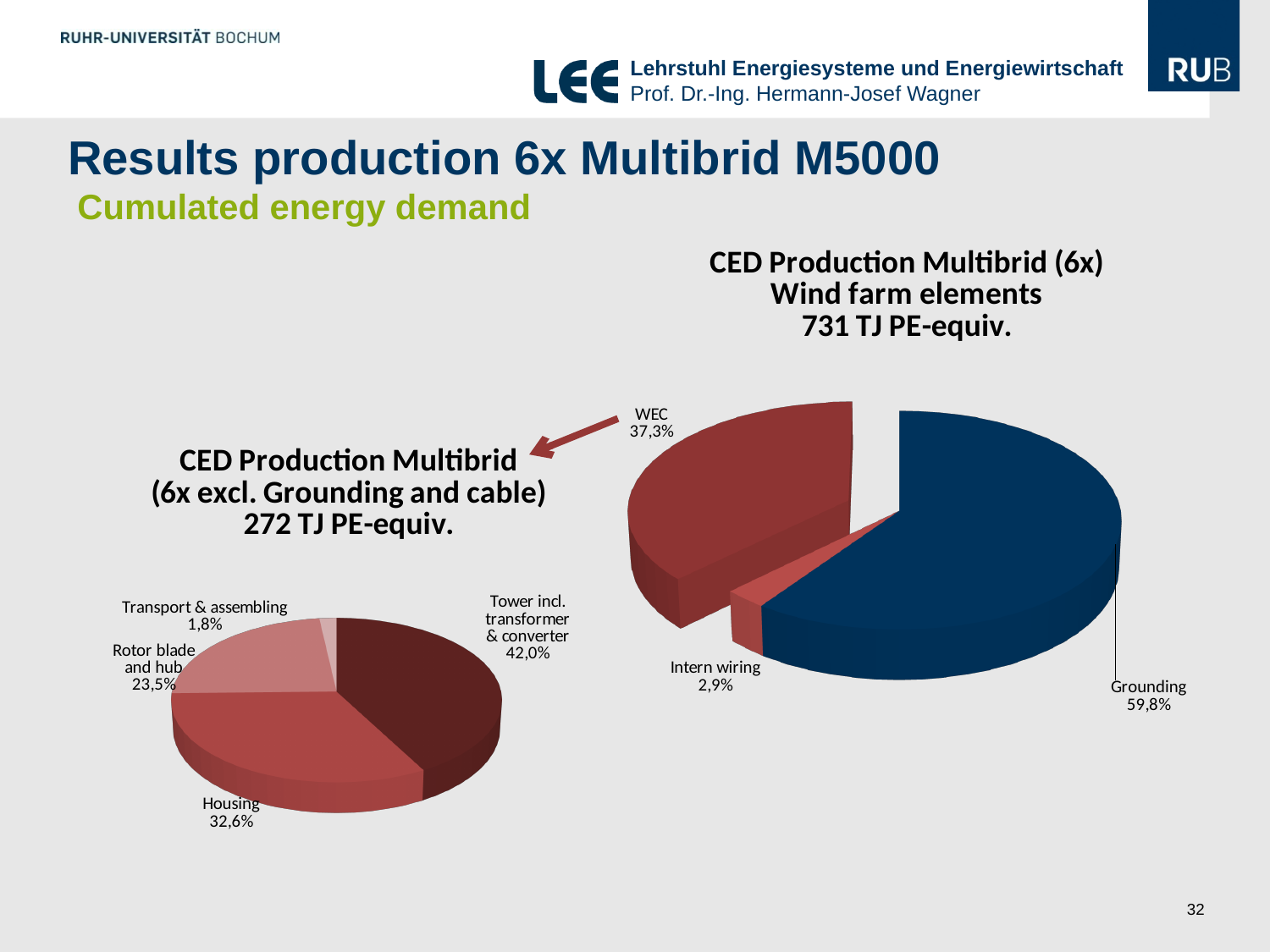
In the 'CED Production Multibrid (6x) Wind farm elements' chart, what share does Intern wiring have? 2,9% What kind of chart is the 'CED Production Multibrid (6x excl. Grounding and cable)' chart? Pie chart In the 'CED Production Multibrid (6x excl. Grounding and cable)' chart, what is the difference in percentage points between Tower incl. transformer & converter and Housing? 9,4 percentage points In the 'CED Production Multibrid (6x) Wind farm elements' chart, what share does Grounding have? 59,8% In the 'CED Production Multibrid (6x excl. Grounding and cable)' chart, what share does Rotor blade and hub have? 23,5% In the 'CED Production Multibrid (6x excl. Grounding and cable)' chart, which slice is the smallest? Transport & assembling What total value is stated in the title of the 'CED Production Multibrid (6x) Wind farm elements' chart? 731 TJ PE-equiv. In the 'CED Production Multibrid (6x excl. Grounding and cable)' chart, what share does Housing have? 32,6% In the 'CED Production Multibrid (6x) Wind farm elements' chart, how many slices are there? 3 In the 'CED Production Multibrid (6x) Wind farm elements' chart, what share does WEC have? 37,3% In the 'CED Production Multibrid (6x excl. Grounding and cable)' chart, which slice is the largest? Tower incl. transformer & converter In the 'CED Production Multibrid (6x) Wind farm elements' chart, which slice is the largest? Grounding